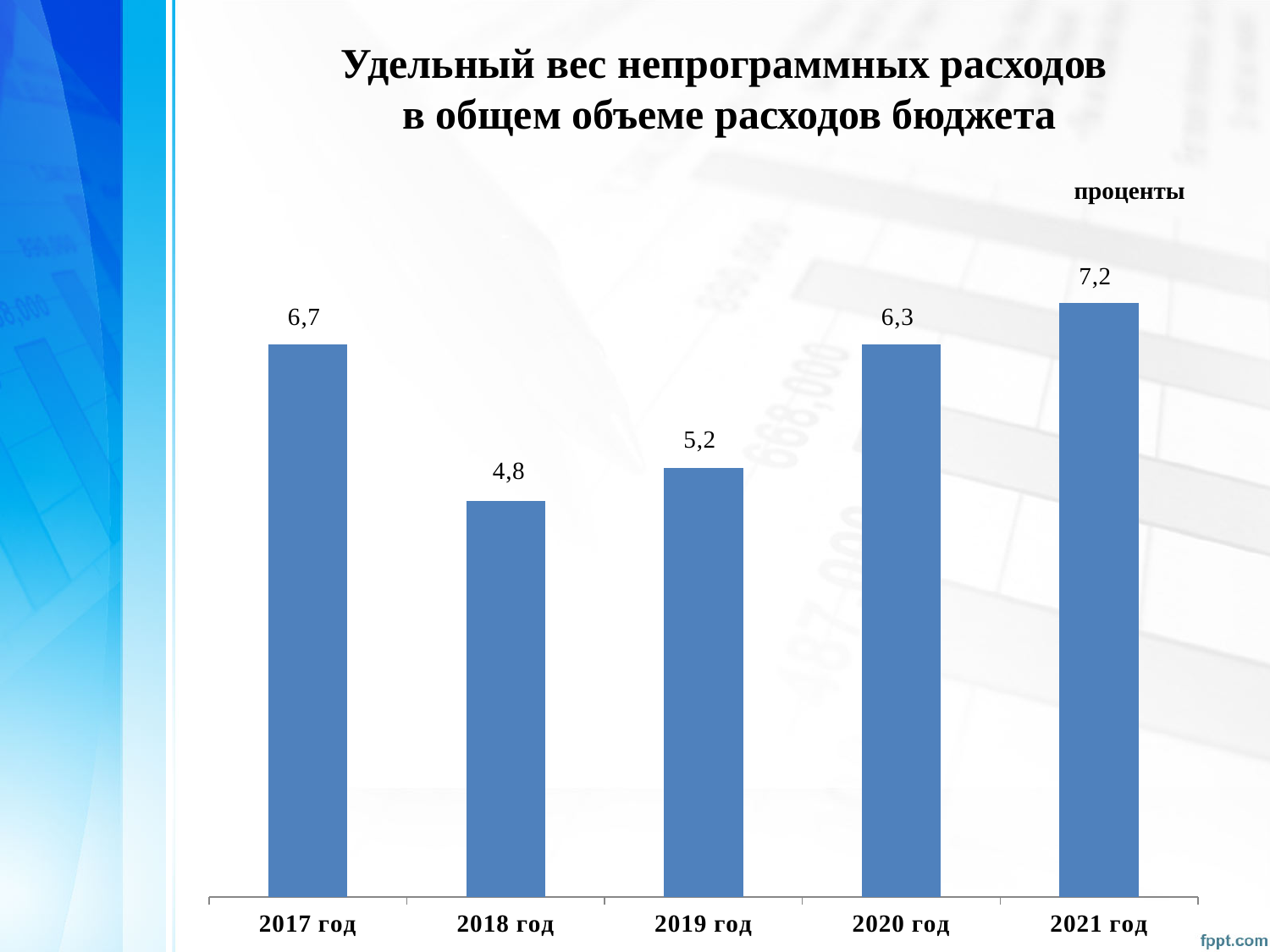
What is the value for 2018 год? 4,8 Which is larger, the value for 2017 год or the value for 2020 год? 2017 год What unit label is shown above the chart? проценты What is the difference between the values for 2021 год and 2018 год? 2,4 What is the value for 2019 год? 5,2 What is the value for 2020 год? 6,3 What is the value for 2021 год? 7,2 Which year has the highest value? 2021 год What is the value for 2017 год? 6,7 Which year has the lowest value? 2018 год What kind of chart is shown on the slide? bar chart How many years are shown on the chart? 5